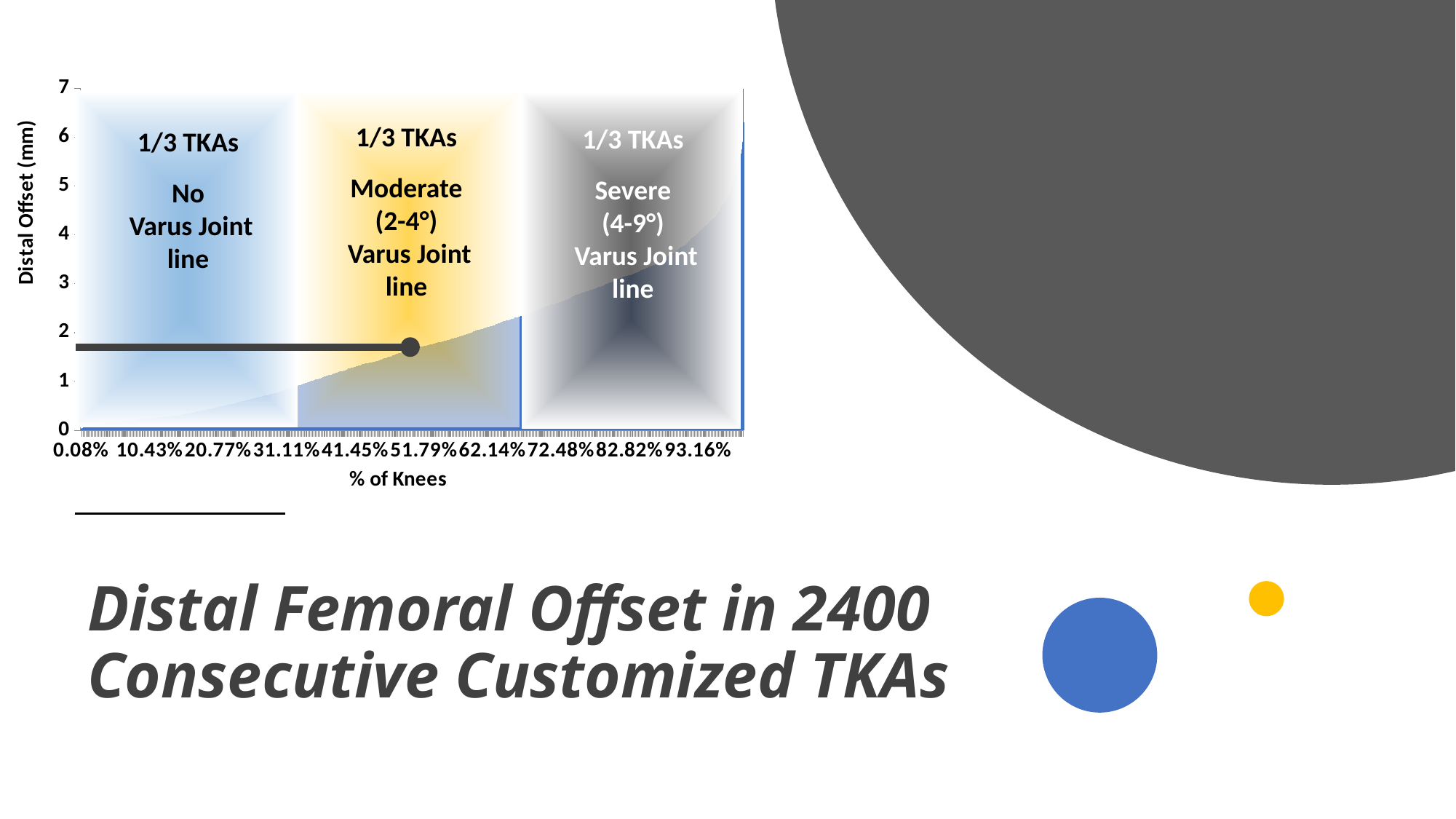
Which is larger, the distal offset at 20.77% of knees or at 62.14% of knees? 62.14% Is the distal offset at 51.79% of knees greater or less than 2 mm? less What is the highest value shown on the y axis of the chart? 7 Is the distal offset at 72.48% of knees greater or less than 2 mm? greater Is the distal offset at 0.08% of knees greater or less than 1 mm? less Does the distal offset rise or fall as the % of Knees increases along the x axis? Rises What kind of chart is shown on the slide? Area chart What is the title of the y axis of the chart? Distal Offset (mm) How many tick labels are shown on the x axis of the chart? 10 What is the title of the x axis of the chart? % of Knees